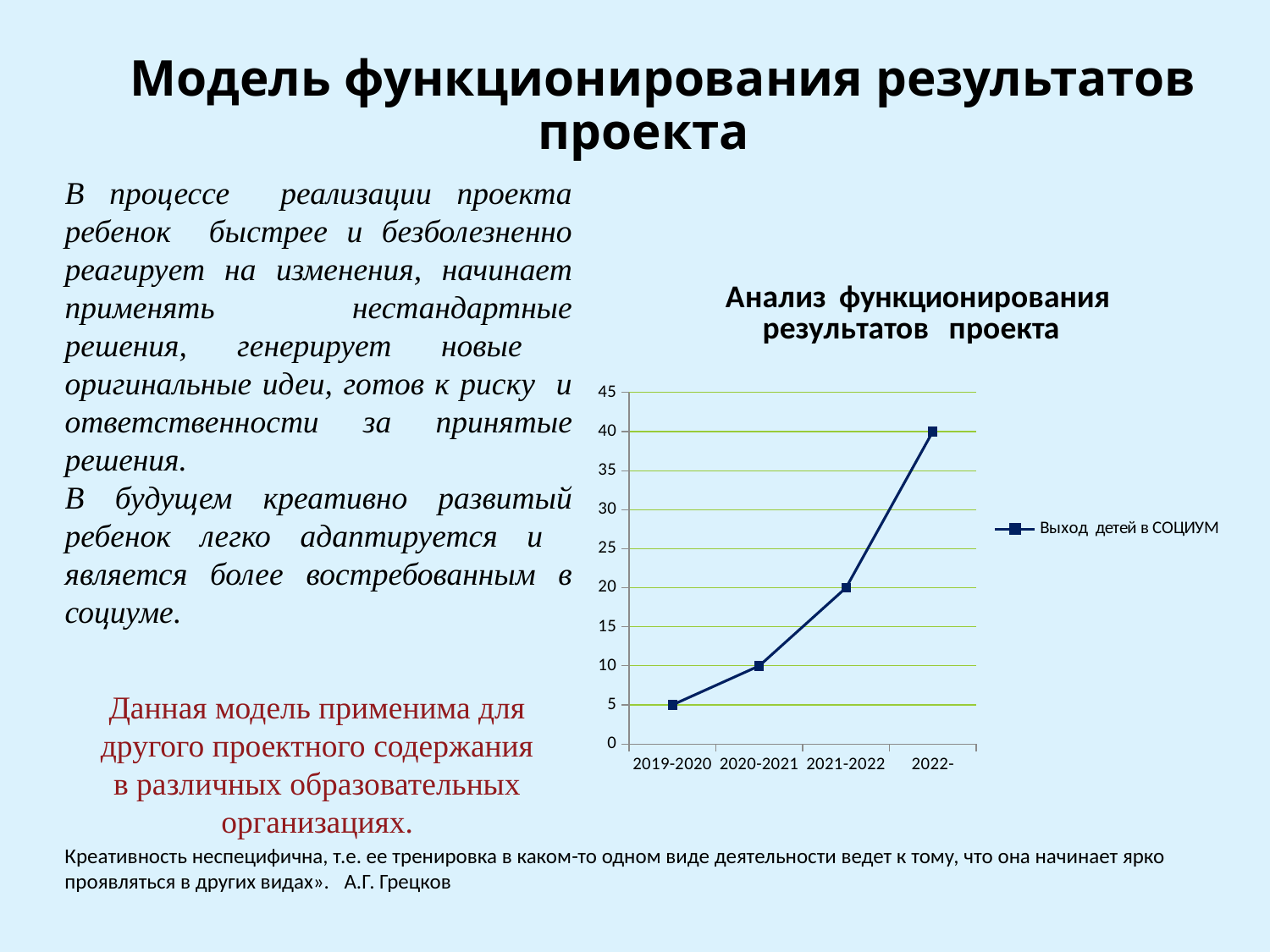
What is the value for 2020-2021? 10 Which period has the highest value? 2022- What is the value for 2019-2020? 5 How many series does the chart legend list? 1 What is the name of the series shown in the legend? Выход детей в СОЦИУМ How many data points are plotted on the line? 4 Which period has the lowest value? 2019-2020 What kind of chart is shown on the slide? line chart What is the value for 2021-2022? 20 Do the values rise or fall from 2019-2020 to 2022-? rise What is the title of the chart? Анализ функционирования результатов проекта What is the value for 2022-? 40